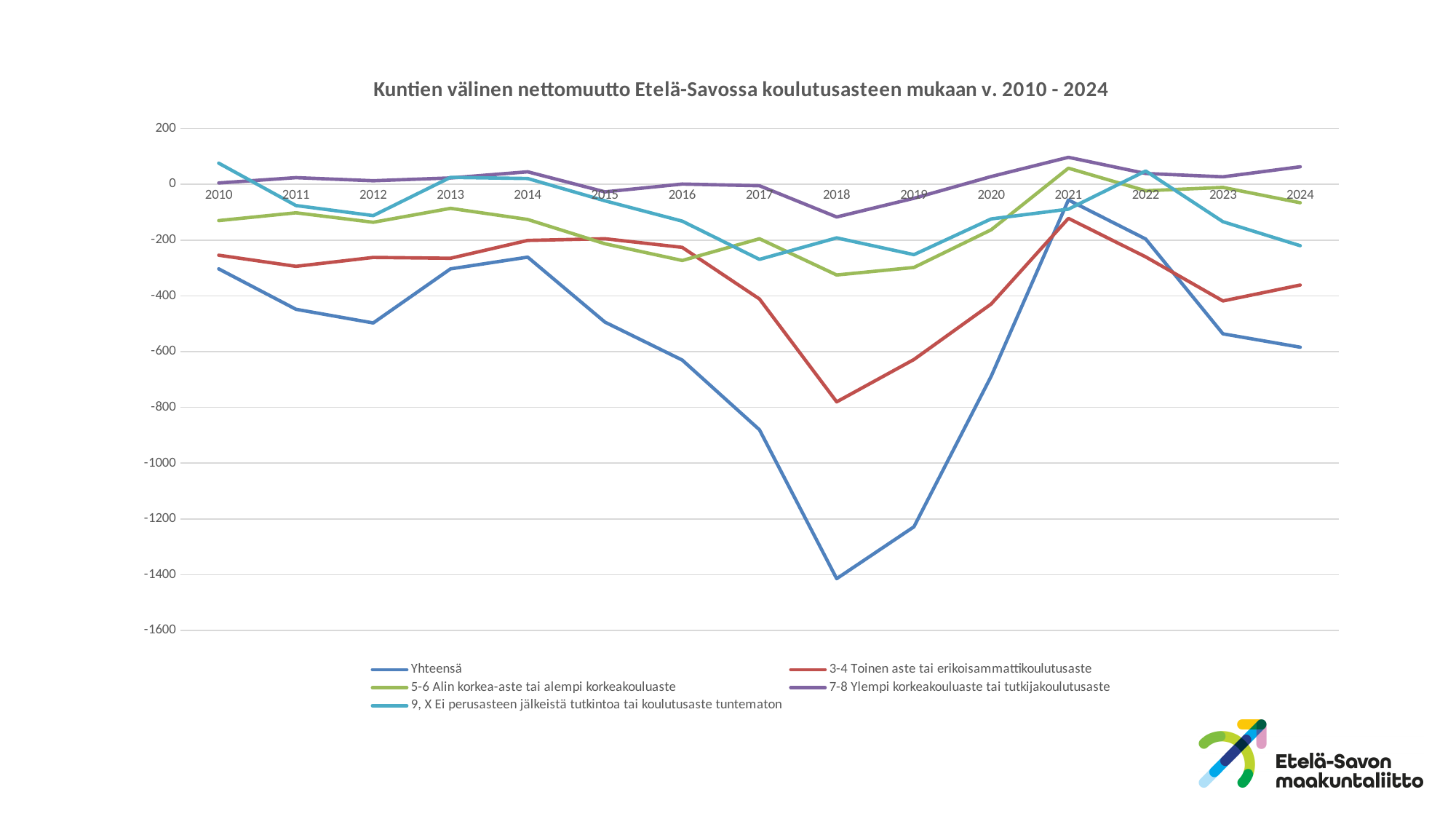
How many series does the legend list? 5 Is the value for Yhteensä in 2012 greater or less than -400? less In which year does the series '7-8 Ylempi korkeakouluaste tai tutkijakoulutusaste' reach its highest value? 2021 In 2018, which is larger: the value for Yhteensä or the value for '3-4 Toinen aste tai erikoisammattikoulutusaste'? 3-4 Toinen aste tai erikoisammattikoulutusaste In which year does the Yhteensä series reach its highest value? 2021 How many years are plotted along the x axis? 15 In which year does the series '3-4 Toinen aste tai erikoisammattikoulutusaste' reach its lowest value? 2018 What kind of chart is shown on the slide? line chart In which year does the Yhteensä series reach its lowest value? 2018 Does the Yhteensä series rise or fall between 2018 and 2021? rise Is the value for Yhteensä in 2018 greater or less than -1200? less What is the title of the chart? Kuntien välinen nettomuutto Etelä-Savossa koulutusasteen mukaan v. 2010 - 2024